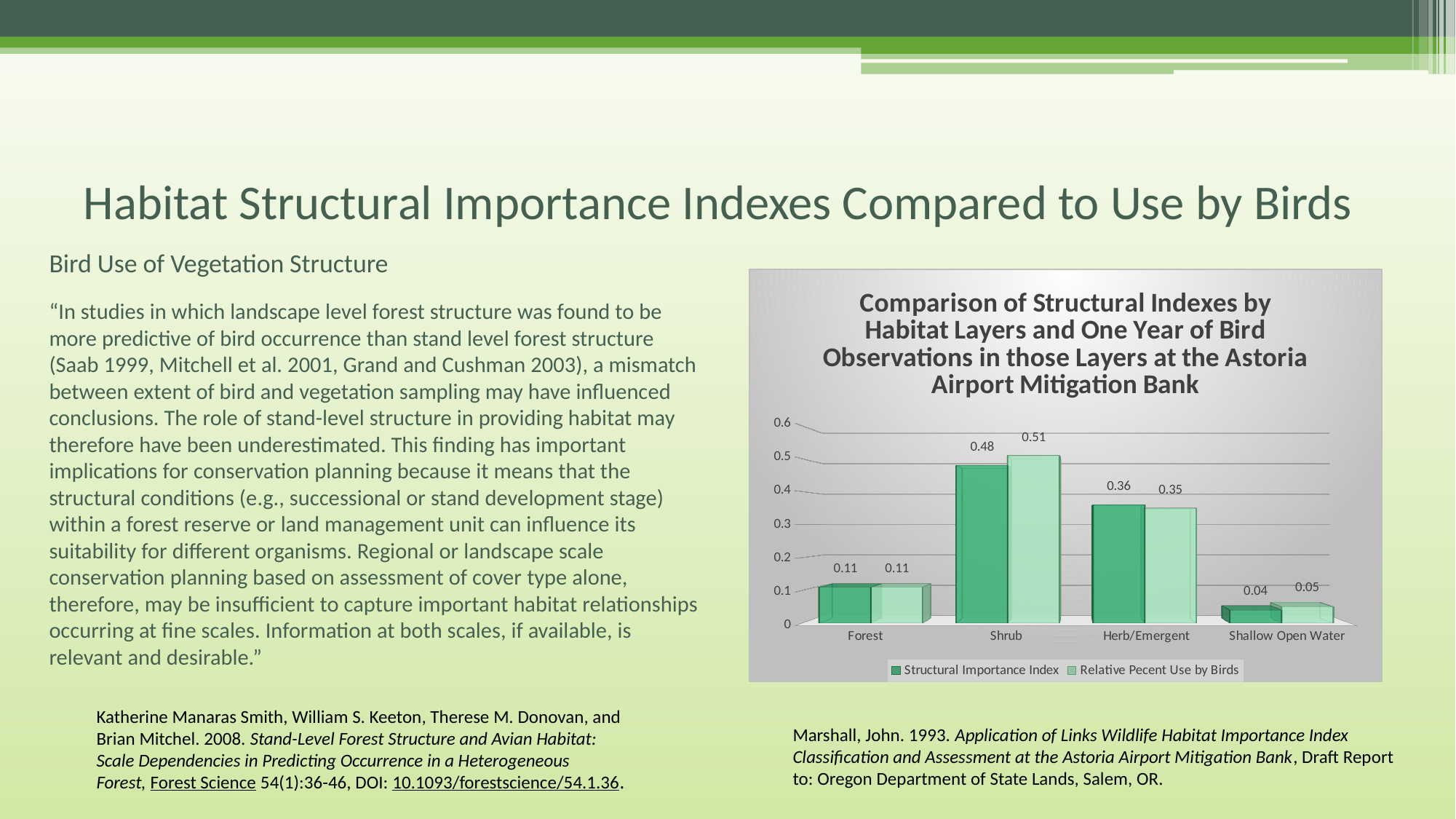
Which is larger: the Structural Importance Index for Herb/Emergent or for Forest? Herb/Emergent Which habitat layer has the lowest Relative Pecent Use by Birds? Shallow Open Water How many habitat layer categories are shown on the x axis? 4 What is the difference between the Relative Pecent Use by Birds for Shrub and for Forest? 0.4 What kind of chart is shown on the slide? Bar chart How many series does the legend list? 2 What is the Relative Pecent Use by Birds value for Herb/Emergent? 0.35 What is the Structural Importance Index value for Shrub? 0.48 Is the Structural Importance Index for Shrub greater or less than 0.4? greater Which habitat layer has the highest Structural Importance Index? Shrub What are the two series named in the chart legend? Structural Importance Index and Relative Pecent Use by Birds What is the Relative Pecent Use by Birds value for Shallow Open Water? 0.05